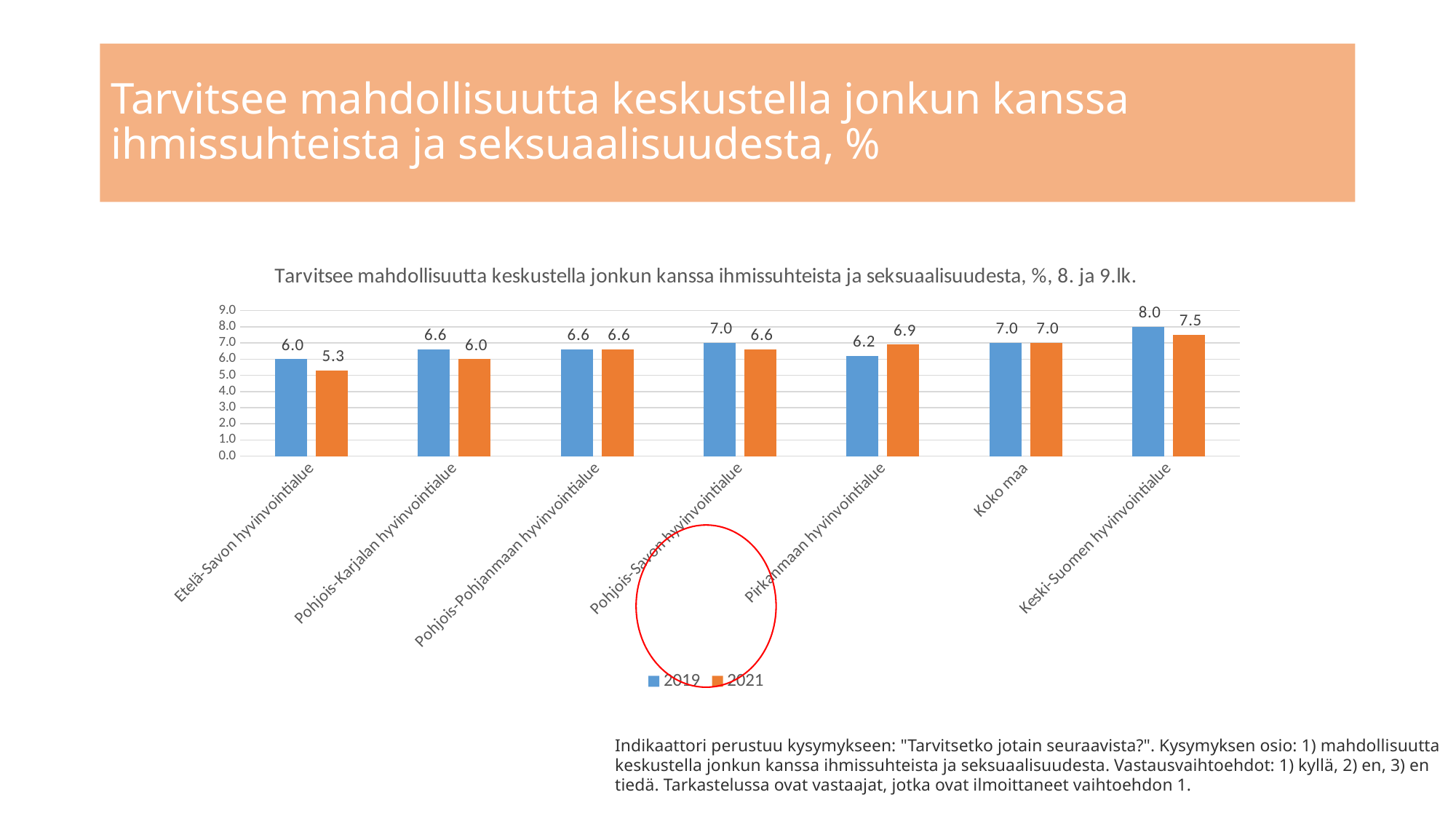
What is the difference between the 2019 and 2021 values for Pohjois-Karjalan hyvinvointialue? 0.6 Which category has the highest 2019 value? Keski-Suomen hyvinvointialue Which is larger for Pirkanmaan hyvinvointialue, the 2019 value or the 2021 value? 2021 How many categories are shown on the x axis? 7 What is the 2021 value for Etelä-Savon hyvinvointialue? 5.3 Which category has the lowest 2021 value? Etelä-Savon hyvinvointialue How many series does the legend list? 2 What is the 2019 value for Pirkanmaan hyvinvointialue? 6.2 What kind of chart is shown on the slide? Bar chart Which colour represents the 2021 series? Orange What is the 2021 value for Keski-Suomen hyvinvointialue? 7.5 What is the difference between the 2019 value for Keski-Suomen hyvinvointialue and the 2019 value for Etelä-Savon hyvinvointialue? 2.0